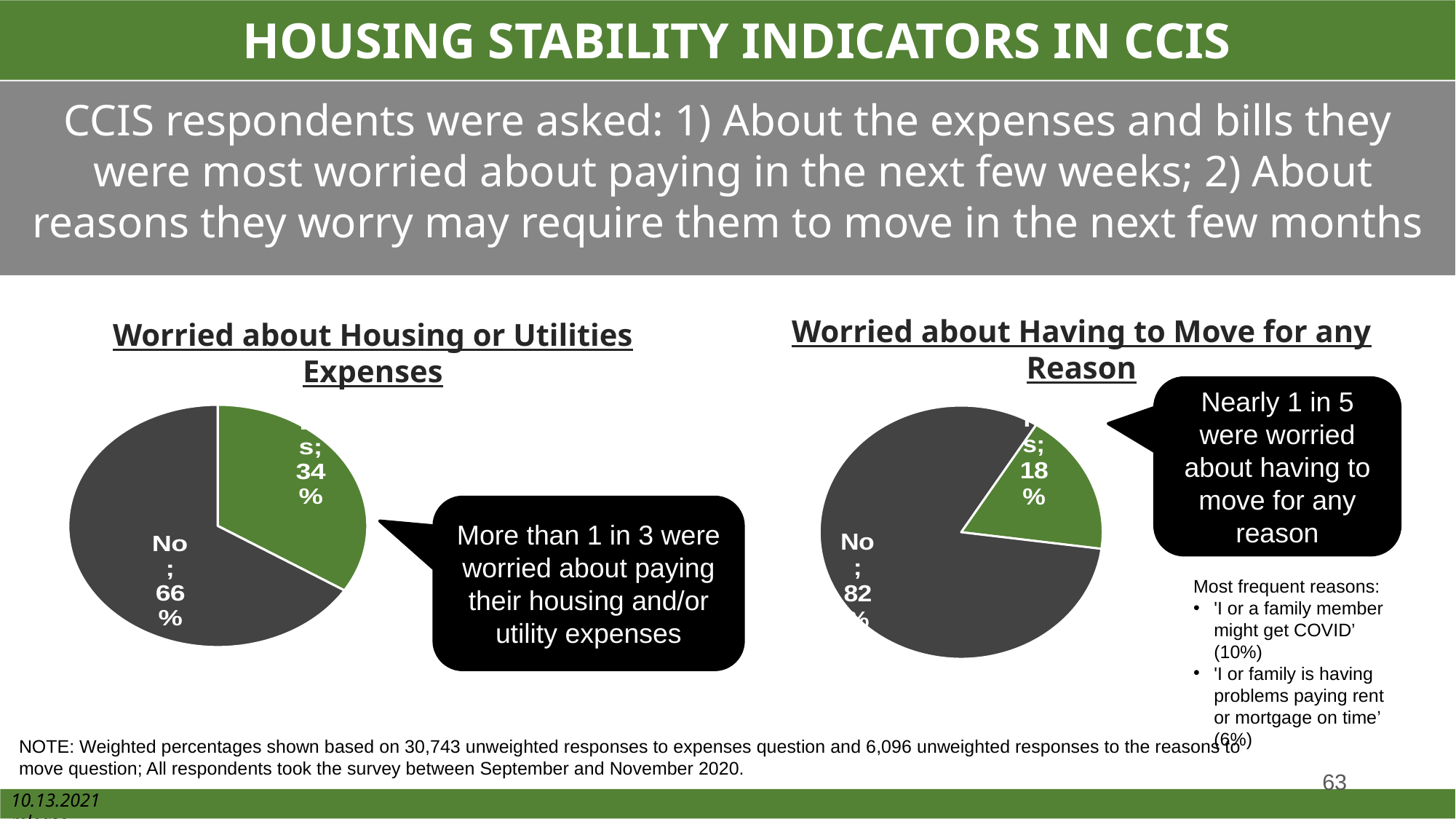
In the 'Worried about Housing or Utilities Expenses' chart, what share of respondents answered No? 66% Which chart has the larger No share: 'Worried about Housing or Utilities Expenses' or 'Worried about Having to Move for any Reason'? Worried about Having to Move for any Reason In the 'Worried about Having to Move for any Reason' chart, what is the difference between the No and Yes shares? 64 percentage points In the 'Worried about Having to Move for any Reason' chart, which slice is the smallest? Yes In the 'Worried about Housing or Utilities Expenses' chart, which slice is the largest? No What type of chart is used for 'Worried about Housing or Utilities Expenses'? pie chart In the 'Worried about Housing or Utilities Expenses' chart, what share does the green (Yes) slice represent? 34% What colour is the No slice in both pie charts? dark grey In the 'Worried about Housing or Utilities Expenses' chart, what is the difference between the No and Yes shares? 32 percentage points In the 'Worried about Having to Move for any Reason' chart, what share of respondents answered No? 82% In the 'Worried about Having to Move for any Reason' chart, what share does the green (Yes) slice represent? 18% How many slices does the 'Worried about Housing or Utilities Expenses' pie chart have? 2